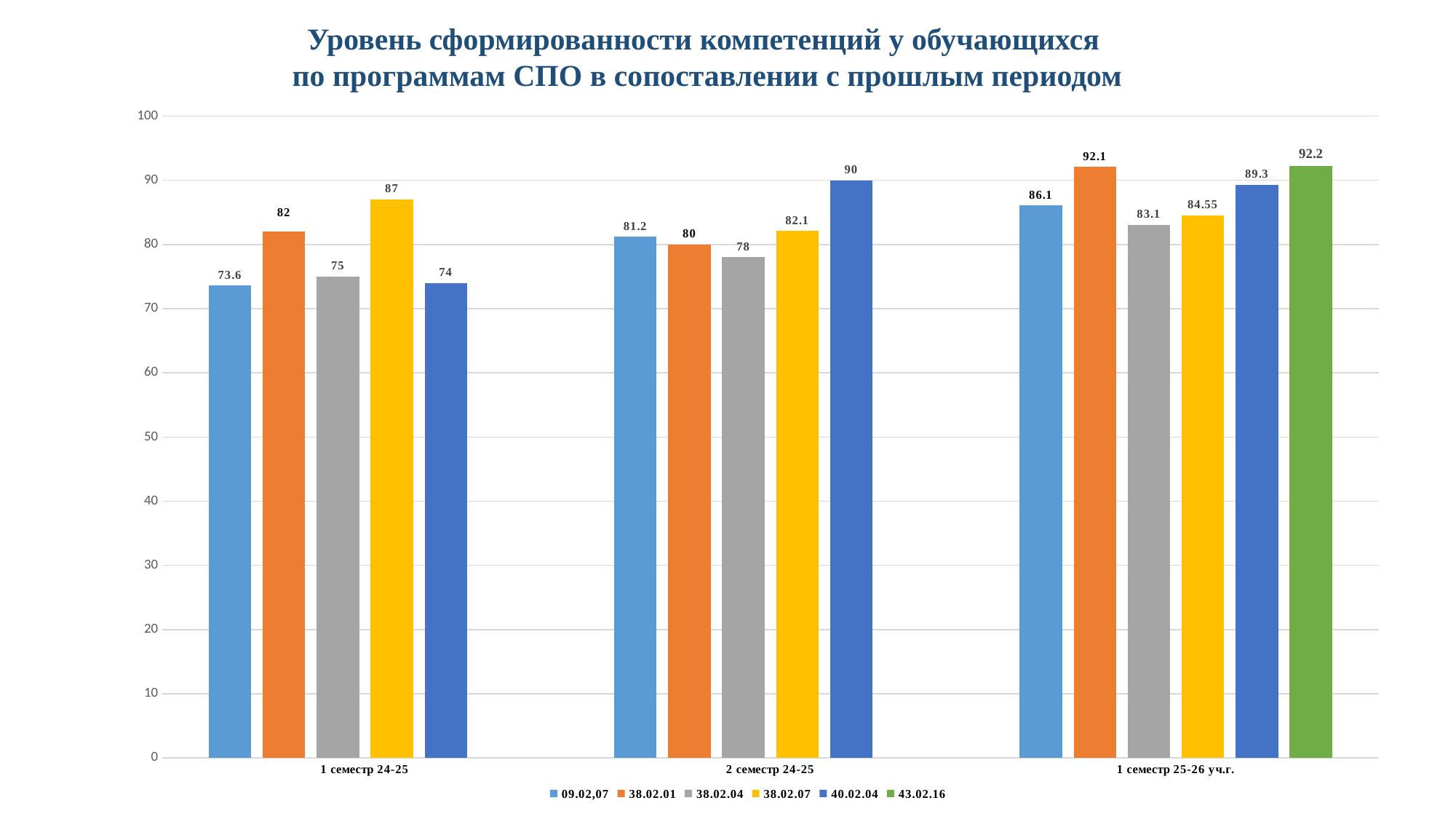
Which series has the lowest value in 2 семестр 24-25? 38.02.04 What is the value for 38.02.07 in 1 семестр 24-25? 87 Do the values for 09.02,07 rise or fall across the three periods from left to right? Rise What kind of chart is shown on the slide? Bar chart Which is larger: the value for 09.02,07 in 2 семестр 24-25 or the value for 38.02.01 in 2 семестр 24-25? 09.02,07 What is the value for 43.02.16 in 1 семестр 25-26 уч.г.? 92.2 Which series has the highest value in 1 семестр 24-25? 38.02.07 How many categories are shown on the x axis? 3 What is the value for 40.02.04 in 2 семестр 24-25? 90 How many series does the legend list? 6 What is the value for 38.02.04 in 1 семестр 25-26 уч.г.? 83.1 What is the difference between the values for 38.02.01 in 1 семестр 25-26 уч.г. and 1 семестр 24-25? 10.1